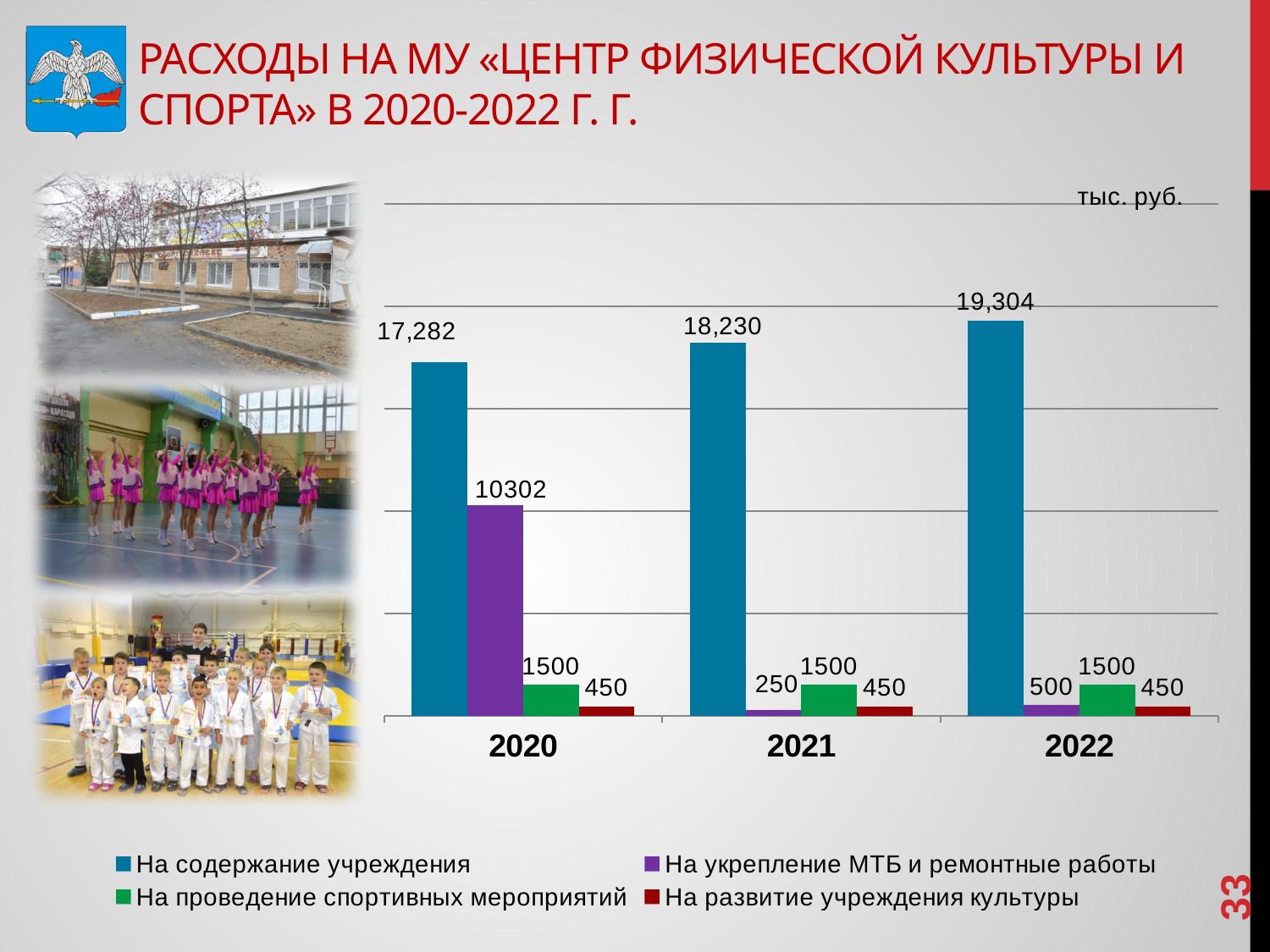
What kind of chart is shown on the slide? Bar chart How many series does the legend list? 4 Which is larger: «На укрепление МТБ и ремонтные работы» in 2022 or in 2021? 2022 What is the value for «На укрепление МТБ и ремонтные работы» in 2021? 250 What is the value for «На укрепление МТБ и ремонтные работы» in 2020? 10302 What is the value for «На развитие учреждения культуры» in 2022? 450 What is the difference between the «На содержание учреждения» values for 2022 and 2021? 1,074 How many years are shown on the x axis of the chart? 3 What is the value for «На содержание учреждения» in 2020? 17,282 In which year is the value for «На укрепление МТБ и ремонтные работы» lowest? 2021 Does the value for «На содержание учреждения» rise or fall from 2020 to 2022? Rises In which year is the value for «На содержание учреждения» highest? 2022